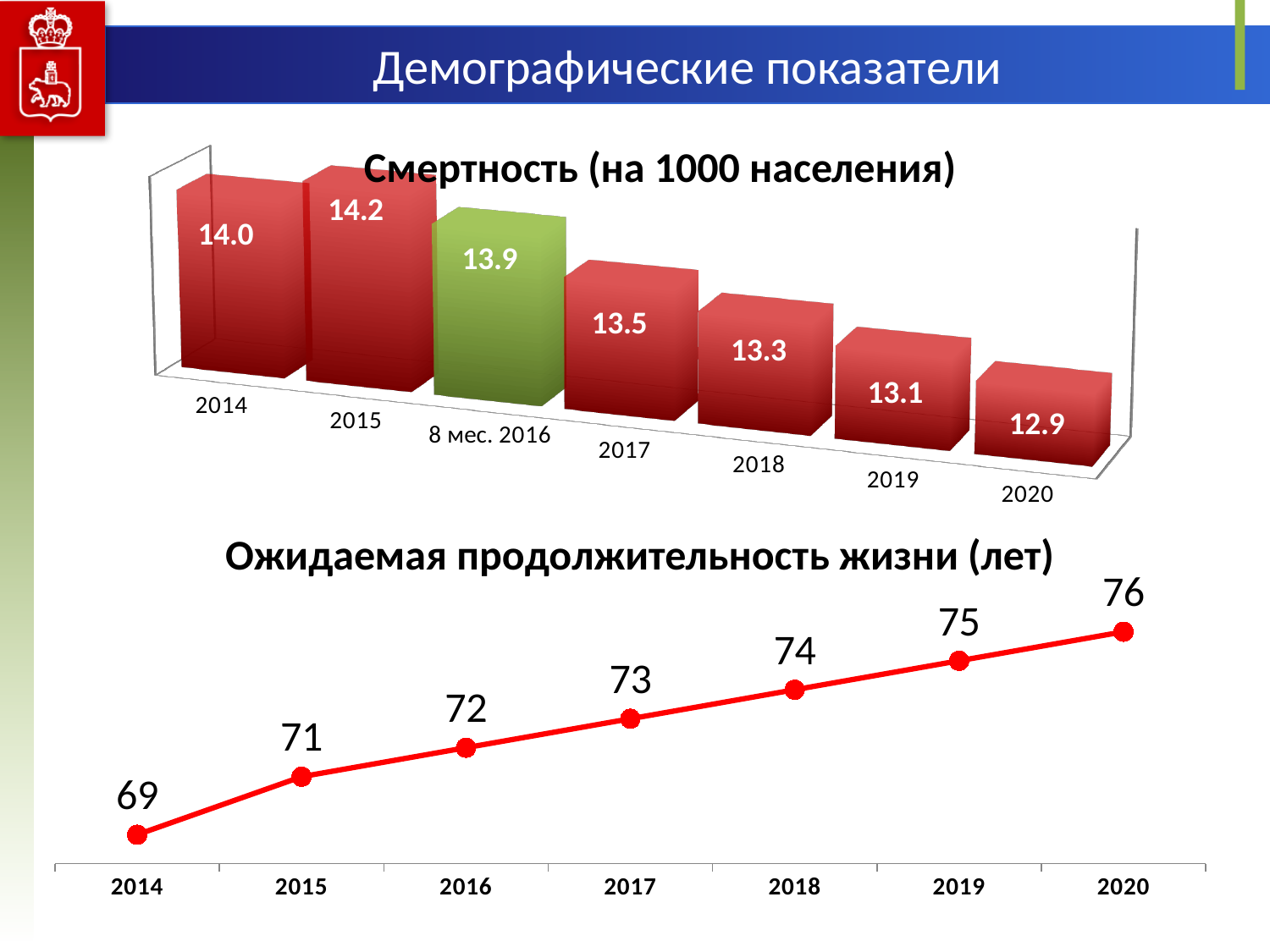
In the chart titled 'Ожидаемая продолжительность жизни (лет)', do the values rise or fall from 2014 to 2020? rise In the chart titled 'Ожидаемая продолжительность жизни (лет)', what is the value for 2018? 74 In the chart titled 'Смертность (на 1000 населения)', which category has the highest value? 2015 In the chart titled 'Смертность (на 1000 населения)', which bar is coloured green rather than red? 8 мес. 2016 In the chart titled 'Смертность (на 1000 населения)', what is the value for '8 мес. 2016'? 13.9 In the chart titled 'Ожидаемая продолжительность жизни (лет)', what kind of chart is it? line chart In the chart titled 'Ожидаемая продолжительность жизни (лет)', what is the value for 2014? 69 In the chart titled 'Ожидаемая продолжительность жизни (лет)', what is the difference between the values for 2020 and 2014? 7 In the chart titled 'Смертность (на 1000 населения)', which category has the lowest value? 2020 In the chart titled 'Смертность (на 1000 населения)', how many bars are shown? 7 In the chart titled 'Смертность (на 1000 населения)', what is the difference between the values for 2015 and 2020? 1.3 In the chart titled 'Смертность (на 1000 населения)', what is the value for 2014? 14.0